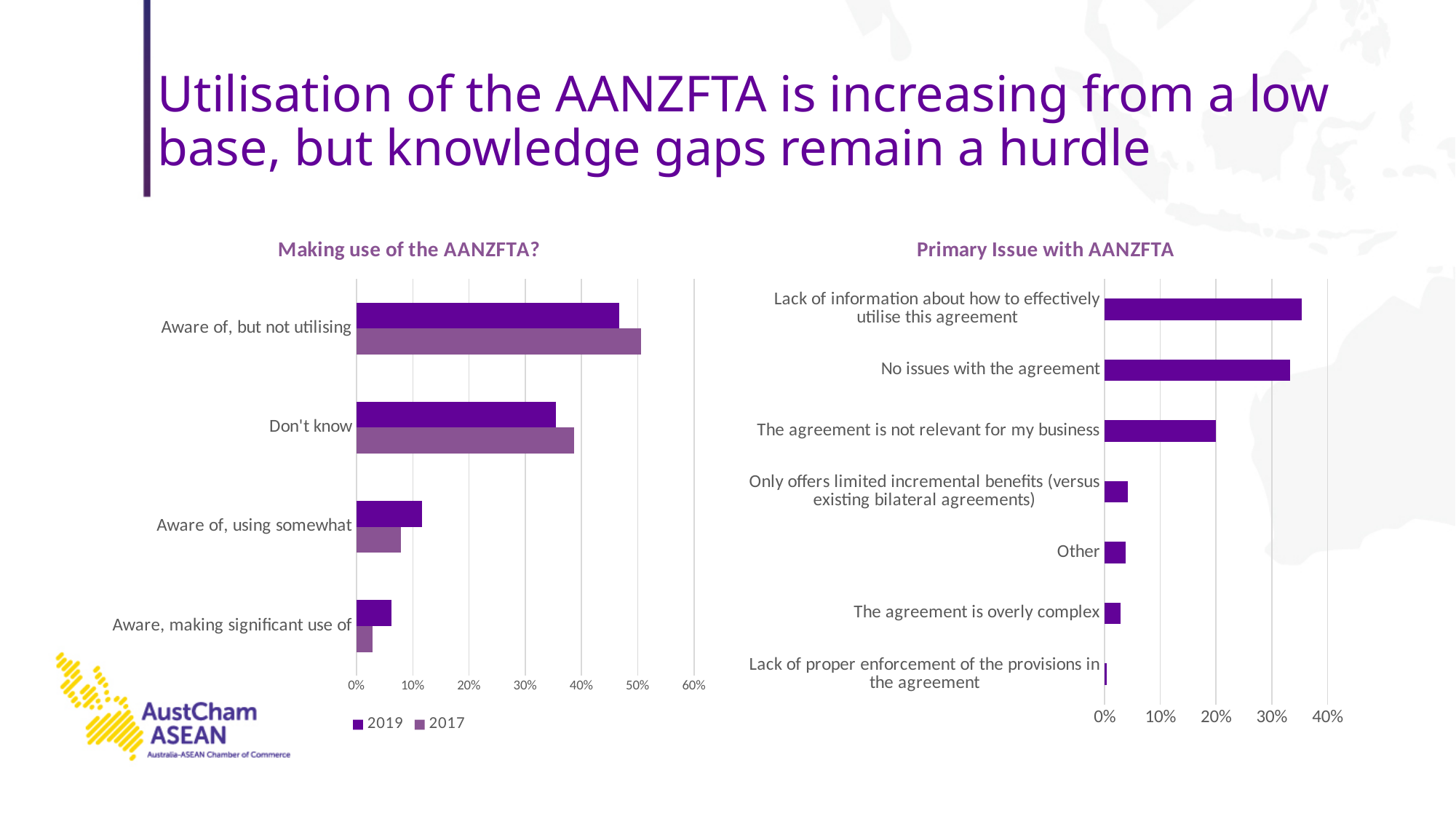
How many categories are shown in the 'Primary Issue with AANZFTA' chart? 7 In 'Primary Issue with AANZFTA', is the value for 'No issues with the agreement' greater or less than 30%? greater What kind of chart is 'Making use of the AANZFTA?'? bar chart In 'Making use of the AANZFTA?', which category has the highest 2019 value? Aware of, but not utilising How many series does the legend of 'Making use of the AANZFTA?' list? 2 In 'Making use of the AANZFTA?', is the 2019 value for 'Aware of, but not utilising' greater or less than 40%? greater In 'Primary Issue with AANZFTA', which category has the lowest value? Lack of proper enforcement of the provisions in the agreement In 'Making use of the AANZFTA?', for 'Aware of, using somewhat', which year has the larger value, 2019 or 2017? 2019 In 'Making use of the AANZFTA?', is the 2017 value for 'Don't know' greater or less than 40%? less In 'Making use of the AANZFTA?', for 'Aware of, but not utilising', which year has the larger value, 2019 or 2017? 2017 In 'Making use of the AANZFTA?', which category has the lowest 2019 value? Aware, making significant use of How many categories are shown in the 'Making use of the AANZFTA?' chart? 4